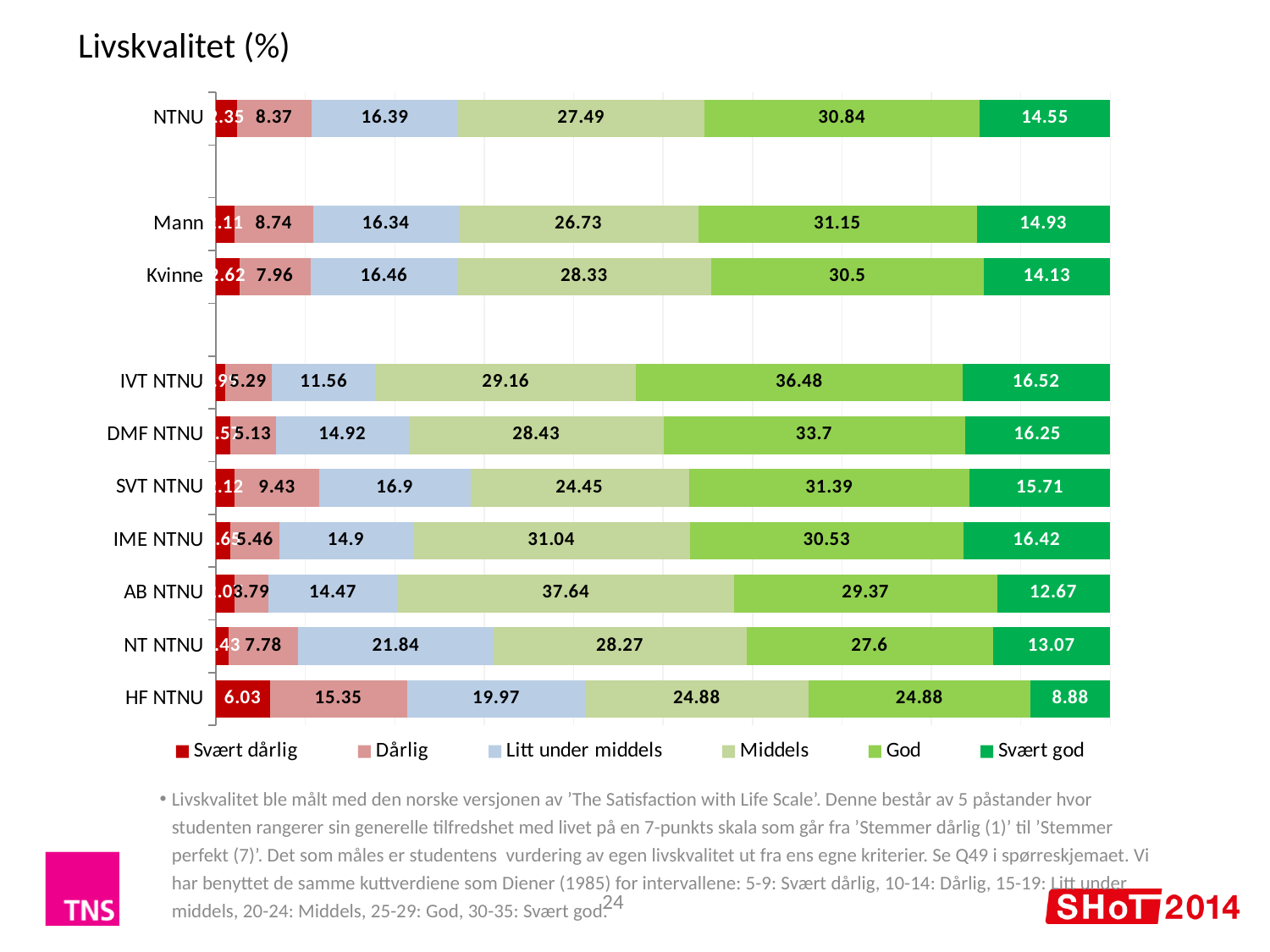
What is the 'God' value for IVT NTNU? 36.48 What is the title of the chart? Livskvalitet (%) What kind of chart is shown on the slide? Stacked bar chart Which category has the lowest 'Svært god' value? HF NTNU What is the 'Svært god' value for NTNU? 14.55 How many series does the legend list? 6 How many categories are plotted on the chart? 10 Which category has the highest 'Svært god' value? IVT NTNU What is the difference between the 'Litt under middels' values for NT NTNU and HF NTNU? 1.87 What is the 'Dårlig' value for HF NTNU? 15.35 Which is larger, the 'God' value for Mann or for Kvinne? Mann What is the 'Middels' value for AB NTNU? 37.64